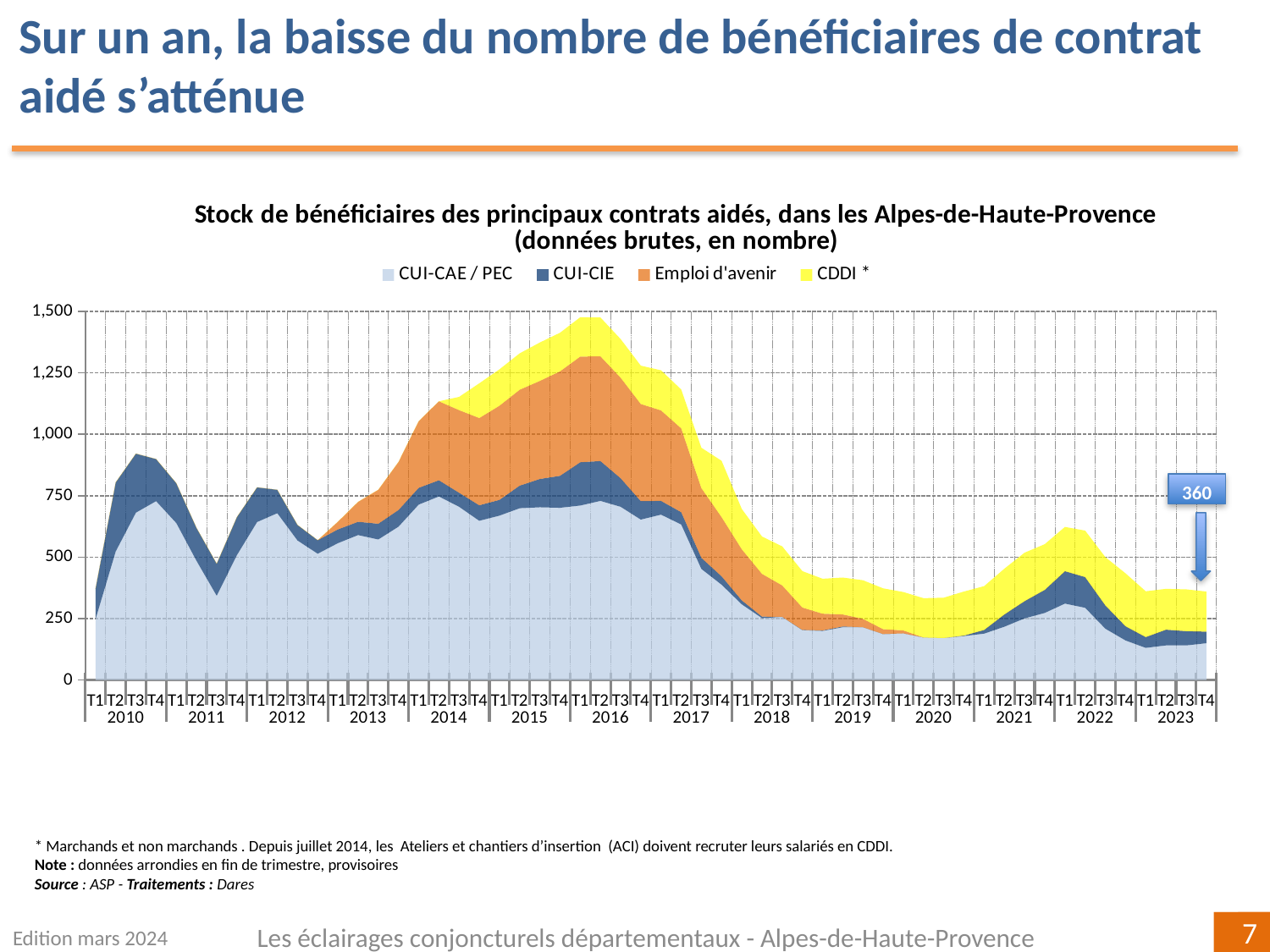
Which series is shown in yellow? CDDI * Which is larger, the total value for T1 2016 or the total value for T1 2023? T1 2016 Is the total value for T1 2016 greater or less than 1,250? greater Between 2017 and 2020, does the total stock of beneficiaries rise or fall? fall Is the total value for T1 2010 greater or less than 500? less In which year does the total stock of beneficiaries reach its highest level? 2016 Is the CUI-CAE / PEC value for T3 2010 greater or less than 500? greater What kind of chart is shown on the slide? stacked area chart How many series does the legend list? 4 How many years are labelled on the x axis? 14 What is the total stock of beneficiaries shown for T4 2023? 360